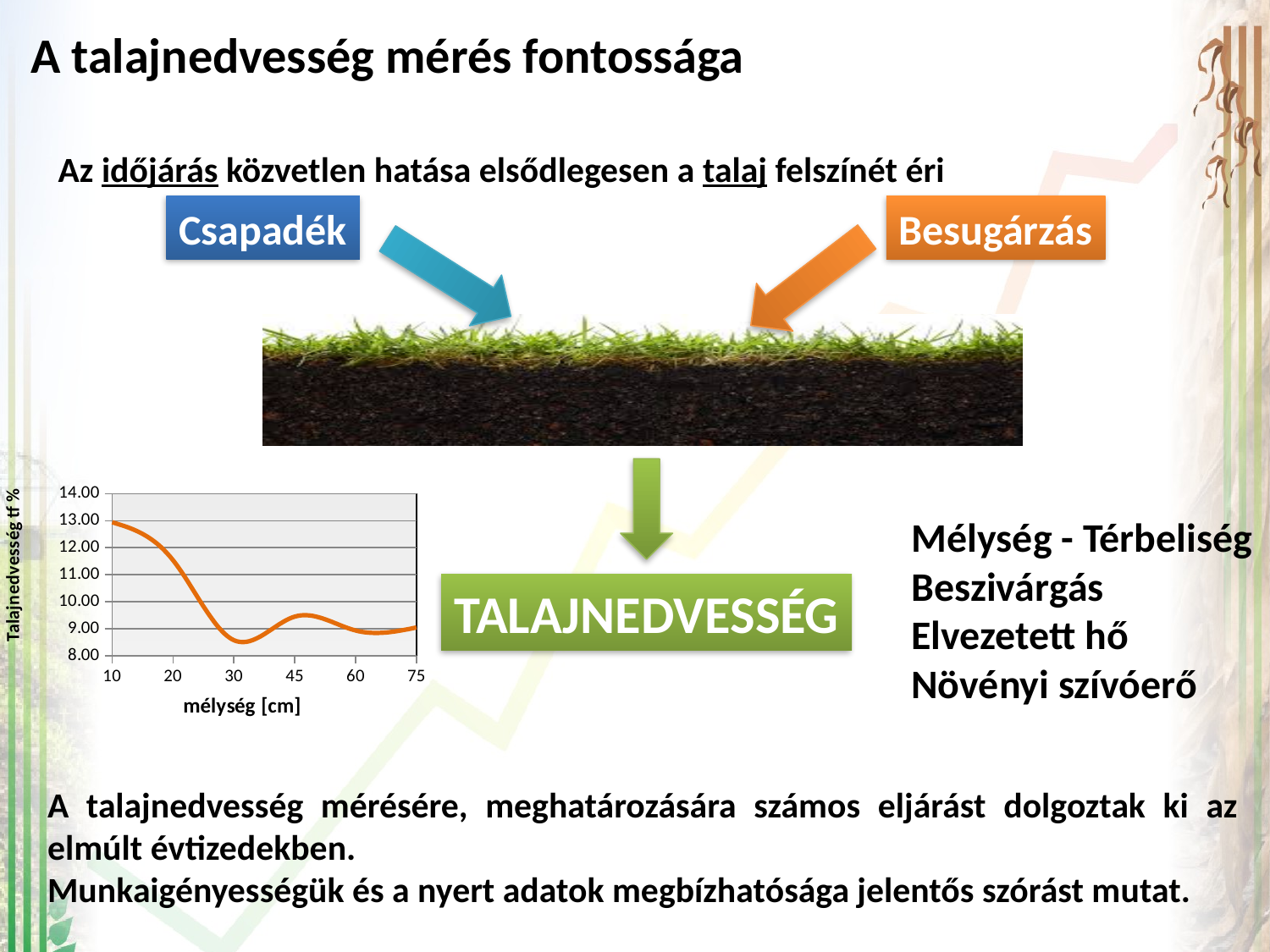
Is the value at a depth of 45 cm greater or less than 9.00? greater At which marked depth is the soil moisture value lowest? 30 Is the value at a depth of 10 cm greater or less than 12.00? greater Does the soil moisture value rise or fall between 10 cm and 30 cm depth? fall What is the title of the x axis of the chart? mélység [cm] How many depth values are marked on the x axis of the chart? 6 Which depth has the larger soil moisture value, 10 cm or 30 cm? 10 cm What kind of chart is shown on the slide? line chart Is the value at a depth of 30 cm greater or less than 9.00? less At which depth is the soil moisture value highest? 10 What is the title of the y axis of the chart? Talajnedvesség tf %